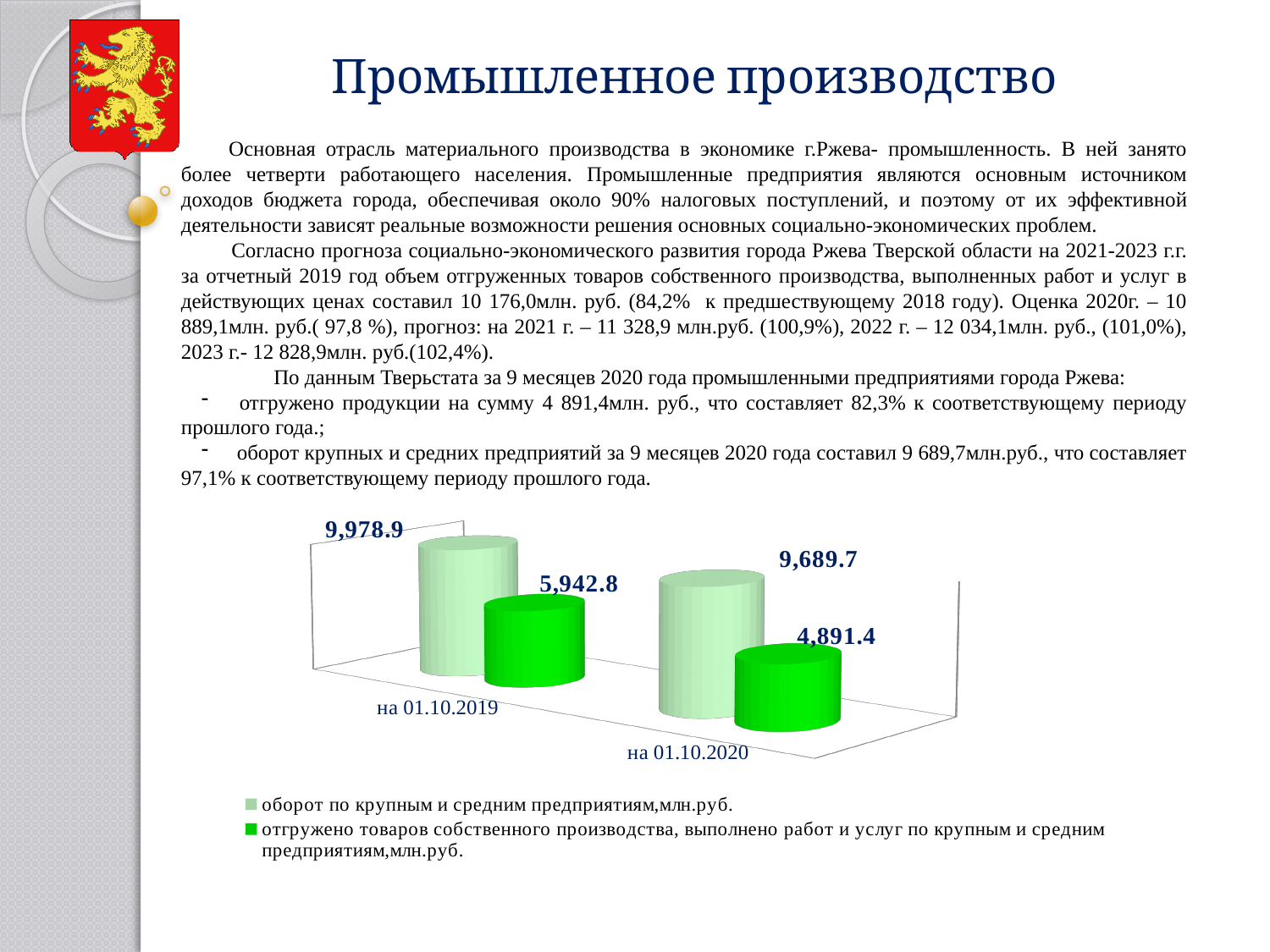
Which category has the highest value for отгружено товаров собственного производства? на 01.10.2019 Which is larger for на 01.10.2020: оборот по крупным и средним предприятиям or отгружено товаров собственного производства? оборот по крупным и средним предприятиям What kind of chart is shown on the slide? bar chart What is the value of отгружено товаров собственного производства for на 01.10.2019? 5,942.8 What is the difference between the оборот по крупным и средним предприятиям values for на 01.10.2019 and на 01.10.2020? 289.2 What is the value of оборот по крупным и средним предприятиям for на 01.10.2020? 9,689.7 How many categories are shown on the chart? 2 How many series does the chart legend list? 2 Which category has the lowest value for оборот по крупным и средним предприятиям? на 01.10.2020 What is the value of оборот по крупным и средним предприятиям for на 01.10.2019? 9,978.9 What is the value of отгружено товаров собственного производства for на 01.10.2020? 4,891.4 What is the difference between the отгружено товаров собственного производства values for на 01.10.2019 and на 01.10.2020? 1,051.4